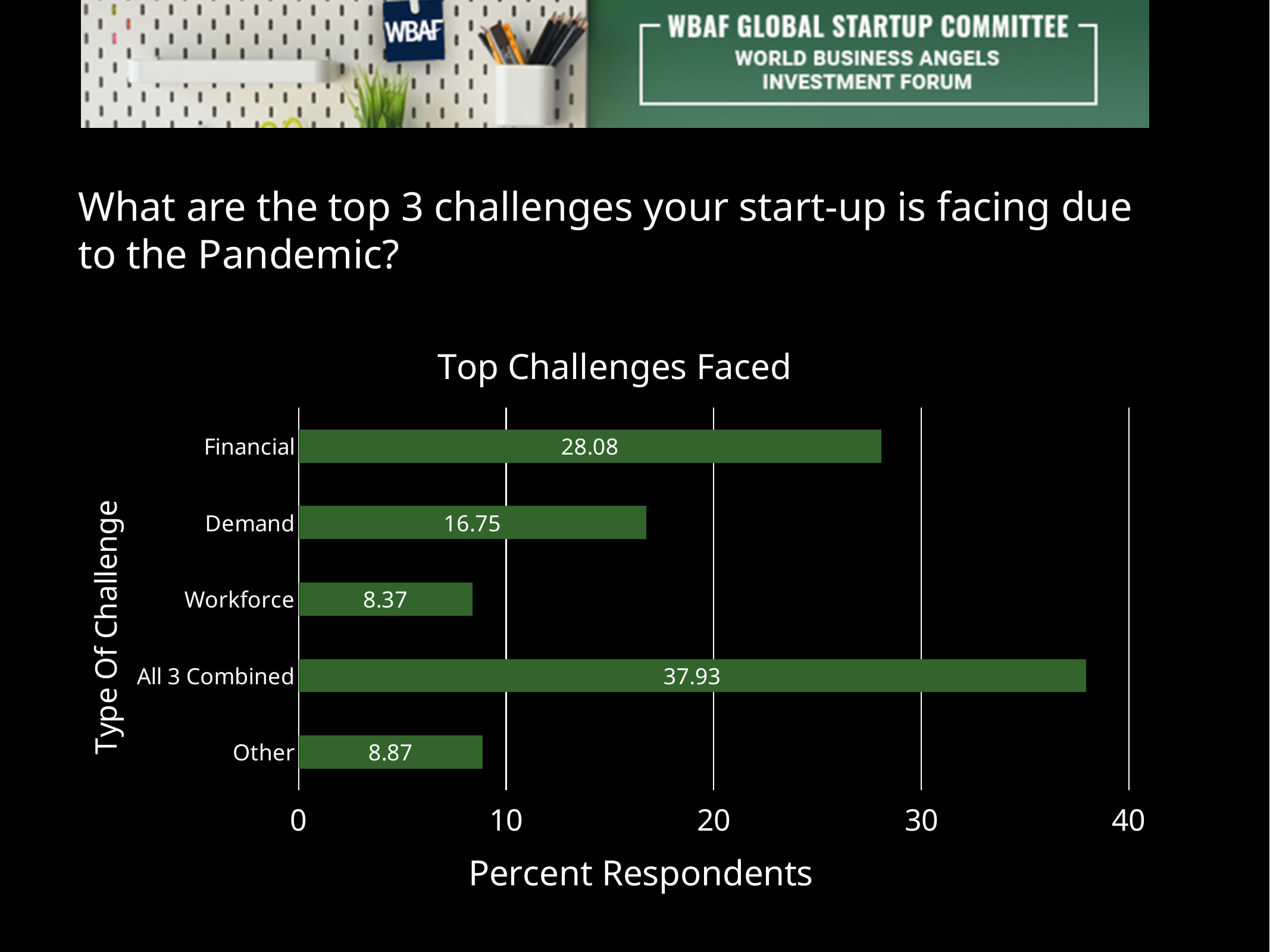
How many types of challenge are shown in the chart? 5 What kind of chart is shown on the slide? bar chart Which type of challenge has the highest percent of respondents? All 3 Combined What is the difference between the values for All 3 Combined and Financial? 9.85 What is the label of the horizontal axis of the chart? Percent Respondents What is the value for Financial in the Top Challenges Faced chart? 28.08 What is the difference between the values for Financial and Demand? 11.33 What is the value for Demand in the Top Challenges Faced chart? 16.75 Which is larger, the value for Other or the value for Workforce? Other Which type of challenge has the lowest percent of respondents? Workforce Is the value for Demand greater or less than 20? less What is the value for All 3 Combined in the Top Challenges Faced chart? 37.93